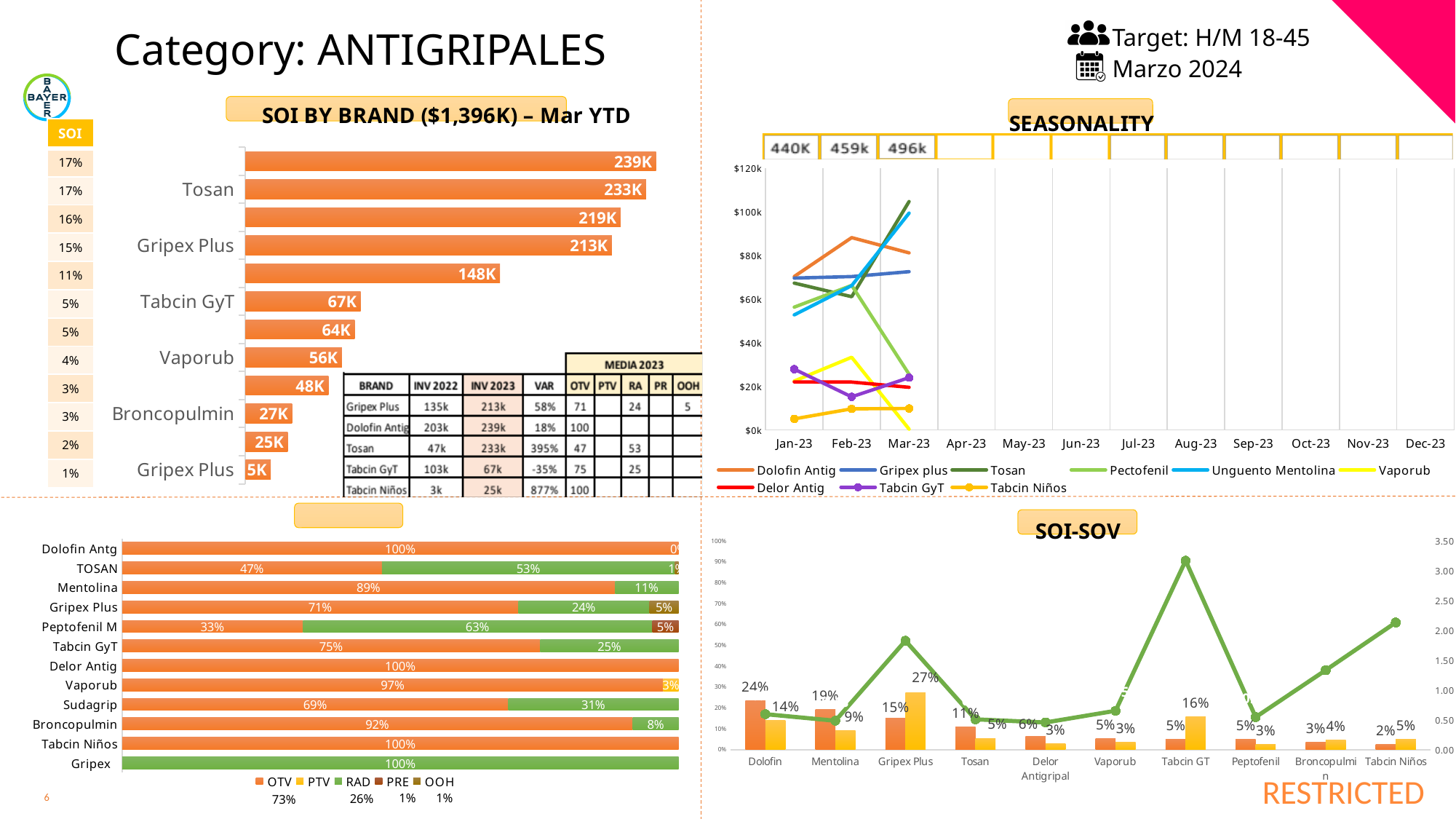
In the 'SOI BY BRAND ($1,396K) – Mar YTD' chart, what is the value for Tabcin GyT? 67K In the SEASONALITY chart, is the value for Tosan in Mar-23 greater or less than $100k? greater In the 'SOI BY BRAND ($1,396K) – Mar YTD' chart, which is larger, Vaporub or Tabcin GyT? Tabcin GyT In the SOI-SOV chart, how many brand categories are shown on the x axis? 10 In the 'SOI BY BRAND ($1,396K) – Mar YTD' chart, what is the difference between the Tosan bar and the Broncopulmin bar? 206K In the SEASONALITY chart, is the value for Tabcin Niños in Jan-23 greater or less than $20k? less In the 'SOI BY BRAND ($1,396K) – Mar YTD' chart, what is the value for Tosan? 233K In the SEASONALITY chart, how many series does the legend list? 9 In the bottom-left stacked bar chart, how many series does the legend list? 5 In the SOI-SOV chart, what is the value of the orange bar for Dolofin? 24% What kind of chart is the 'SOI BY BRAND ($1,396K) – Mar YTD' chart? Bar chart In the bottom-left stacked bar chart, what is the OTV share for Peptofenil M? 33%